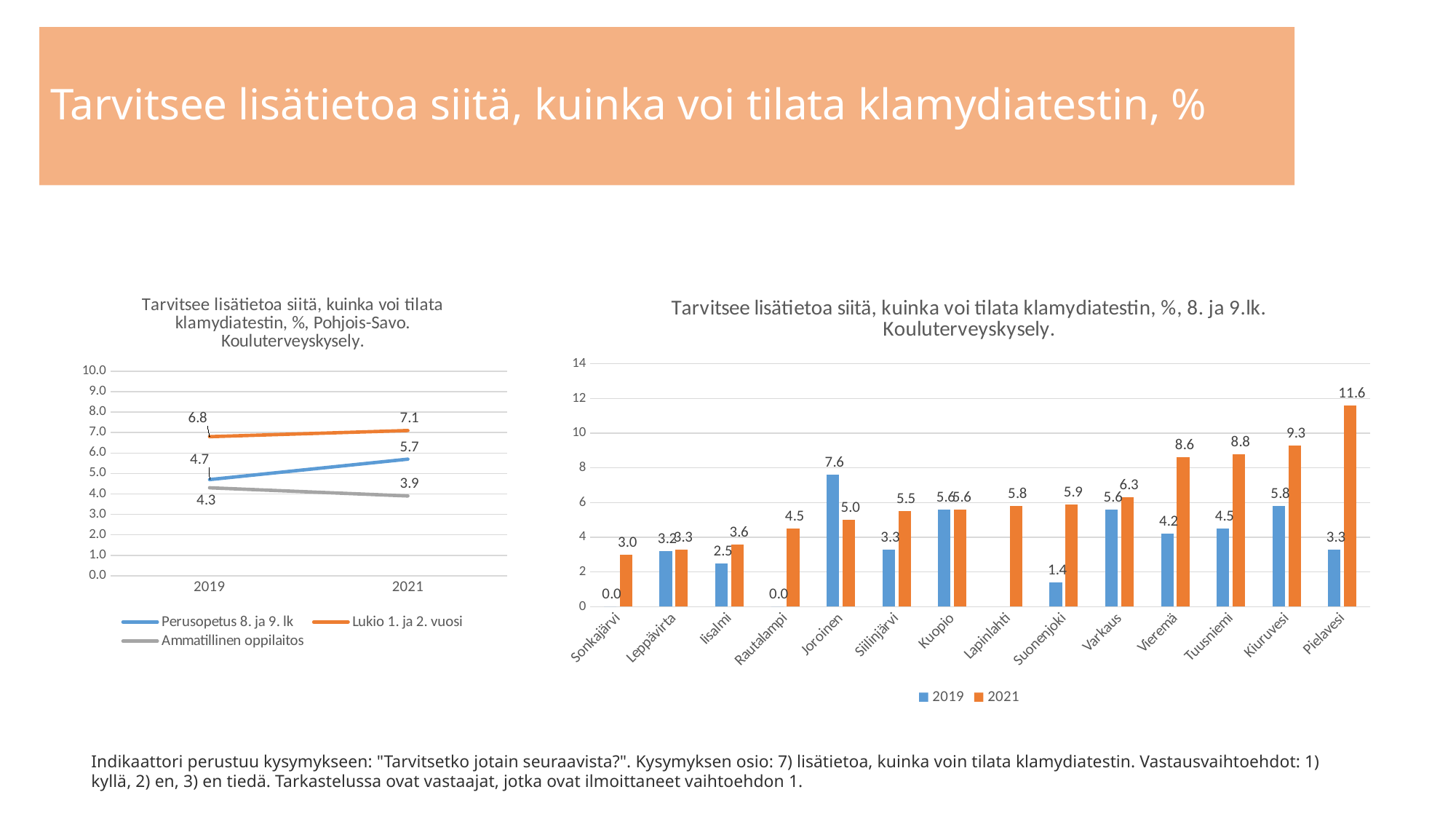
In the right chart (8. ja 9.lk by municipality), how many municipalities are shown on the x axis? 14 In the right chart (8. ja 9.lk by municipality), what is the 2021 value for Pielavesi? 11.6 In the left chart (Pohjois-Savo), how many series does the legend list? 3 In the right chart (8. ja 9.lk by municipality), which municipality has the highest 2019 value? Joroinen In the left chart (Pohjois-Savo), what is the value for Perusopetus 8. ja 9. lk in 2021? 5.7 What kind of chart is the right chart (8. ja 9.lk by municipality)? bar chart In the right chart (8. ja 9.lk by municipality), what is the difference between the 2021 and 2019 values for Vieremä? 4.4 In the right chart (8. ja 9.lk by municipality), which is larger for Joroinen, the 2019 value or the 2021 value? 2019 In the left chart (Pohjois-Savo), what is the value for Ammatillinen oppilaitos in 2019? 4.3 In the left chart (Pohjois-Savo), what is the difference between the Lukio 1. ja 2. vuosi values in 2021 and 2019? 0.3 In the right chart (8. ja 9.lk by municipality), which municipality has the lowest 2021 value? Sonkajärvi In the left chart (Pohjois-Savo), does the value for Ammatillinen oppilaitos rise or fall from 2019 to 2021? fall